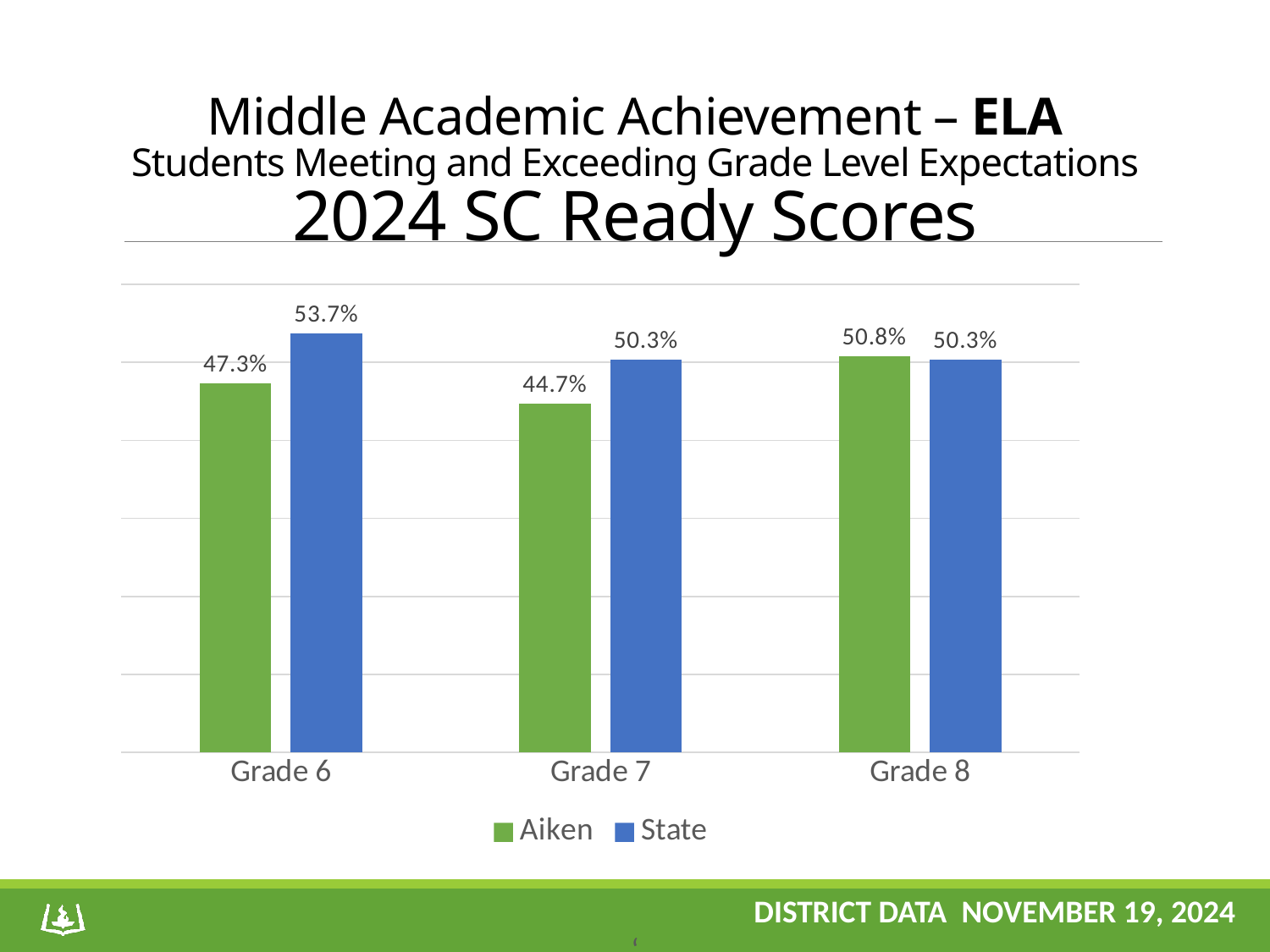
What is the Aiken value for Grade 8? 50.8% What is the Aiken value for Grade 6? 47.3% How many grade categories are shown on the x axis? 3 Which is larger for Grade 6, the Aiken value or the State value? State Which grade has the lowest Aiken value? Grade 7 What is the difference between the State and Aiken values for Grade 7? 5.6% What kind of chart is shown on the slide? Bar chart Which colour represents the Aiken series? Green What is the difference between the State and Aiken values for Grade 6? 6.4% What is the State value for Grade 7? 50.3% How many series does the legend list? 2 Which grade has the highest State value? Grade 6